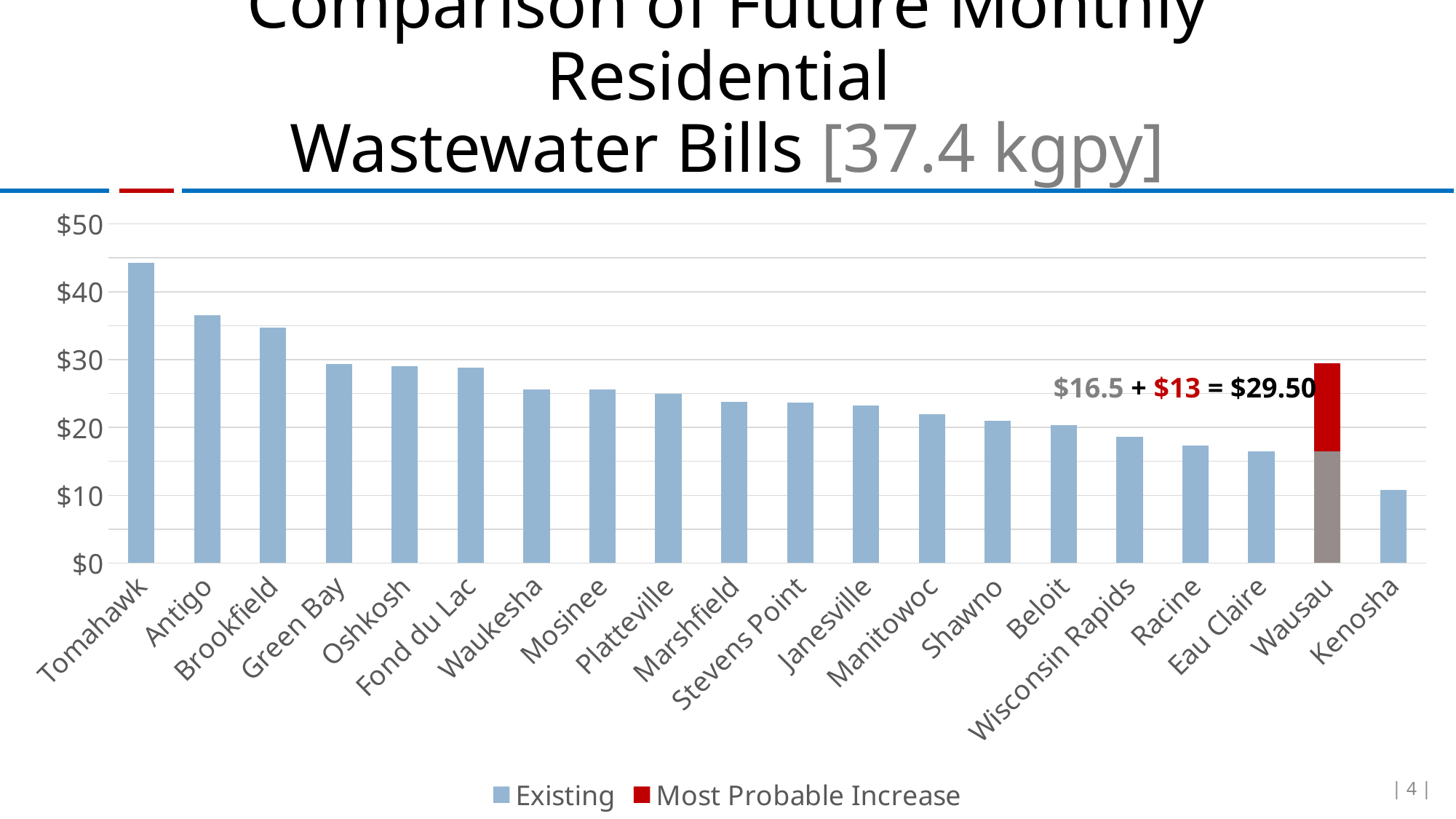
Which city has the lowest monthly wastewater bill? Kenosha What is the most probable increase for Wausau? $13 Is the value for Tomahawk greater or less than $40? greater How many cities are shown on the x axis of the chart? 20 How many series does the legend list? 2 Is the value for Racine greater or less than $20? less What is the existing monthly bill for Wausau? $16.5 What kind of chart is shown on the slide? bar chart What is the total future monthly bill for Wausau (existing plus most probable increase)? $29.50 Which city has the highest existing monthly wastewater bill? Tomahawk Which is larger, the bill for Tomahawk or the bill for Antigo? Tomahawk Do the existing bills rise or fall moving from left to right along the x axis? fall